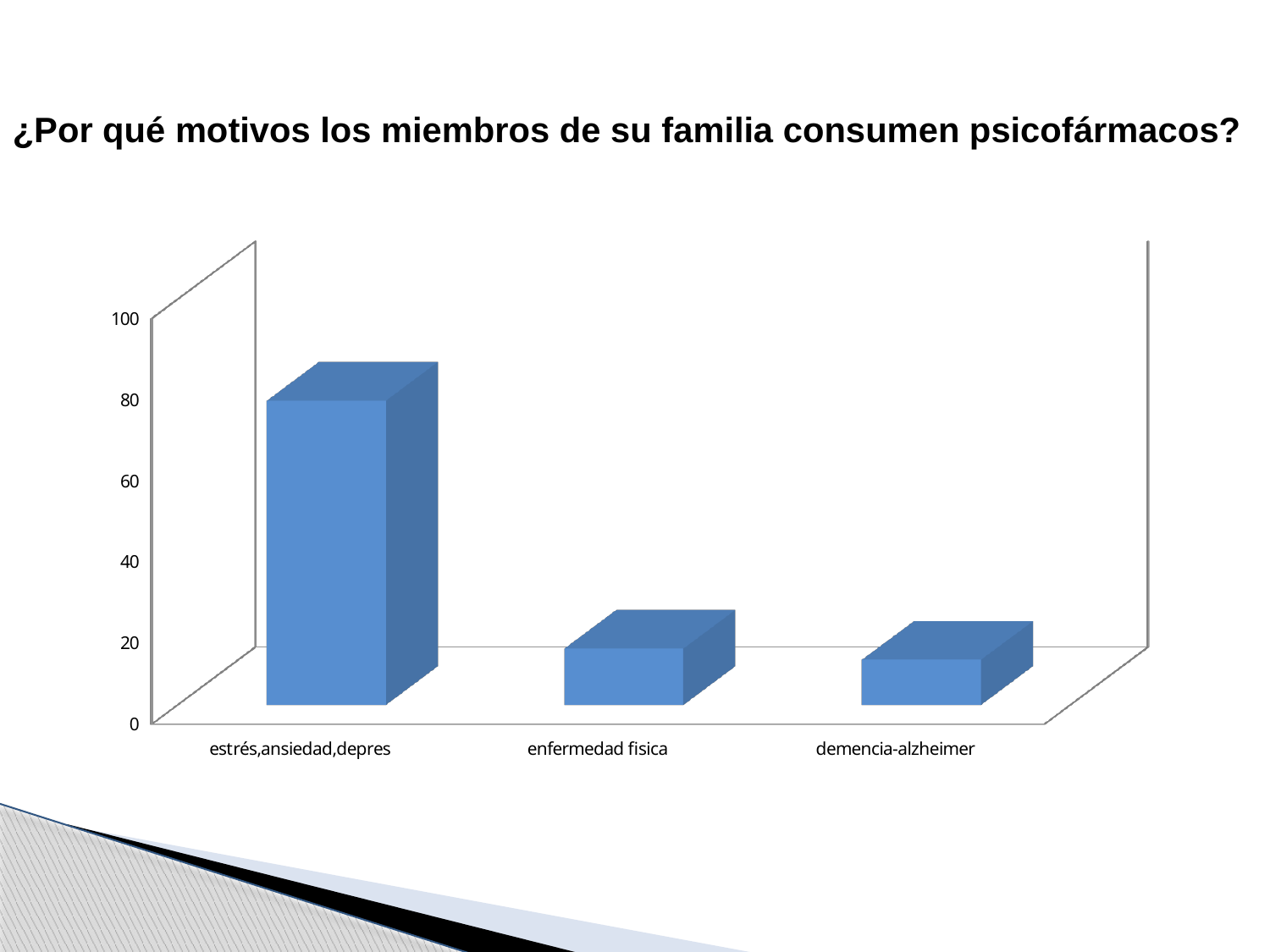
What type of chart is shown on the slide? bar chart Is the value for demencia-alzheimer greater or less than 40? less Which category has the highest value in the chart? estrés,ansiedad,depres Is the value for estrés,ansiedad,depres greater or less than 60? greater Which is larger, the value for estrés,ansiedad,depres or the value for enfermedad fisica? estrés,ansiedad,depres How many categories are shown on the x axis of the chart? 3 Is the value for enfermedad fisica greater or less than 40? less What is the highest value shown on the vertical axis of the chart? 100 Which is larger, the value for demencia-alzheimer or the value for estrés,ansiedad,depres? estrés,ansiedad,depres What is the title of the slide containing the chart? ¿Por qué motivos los miembros de su familia consumen psicofármacos?